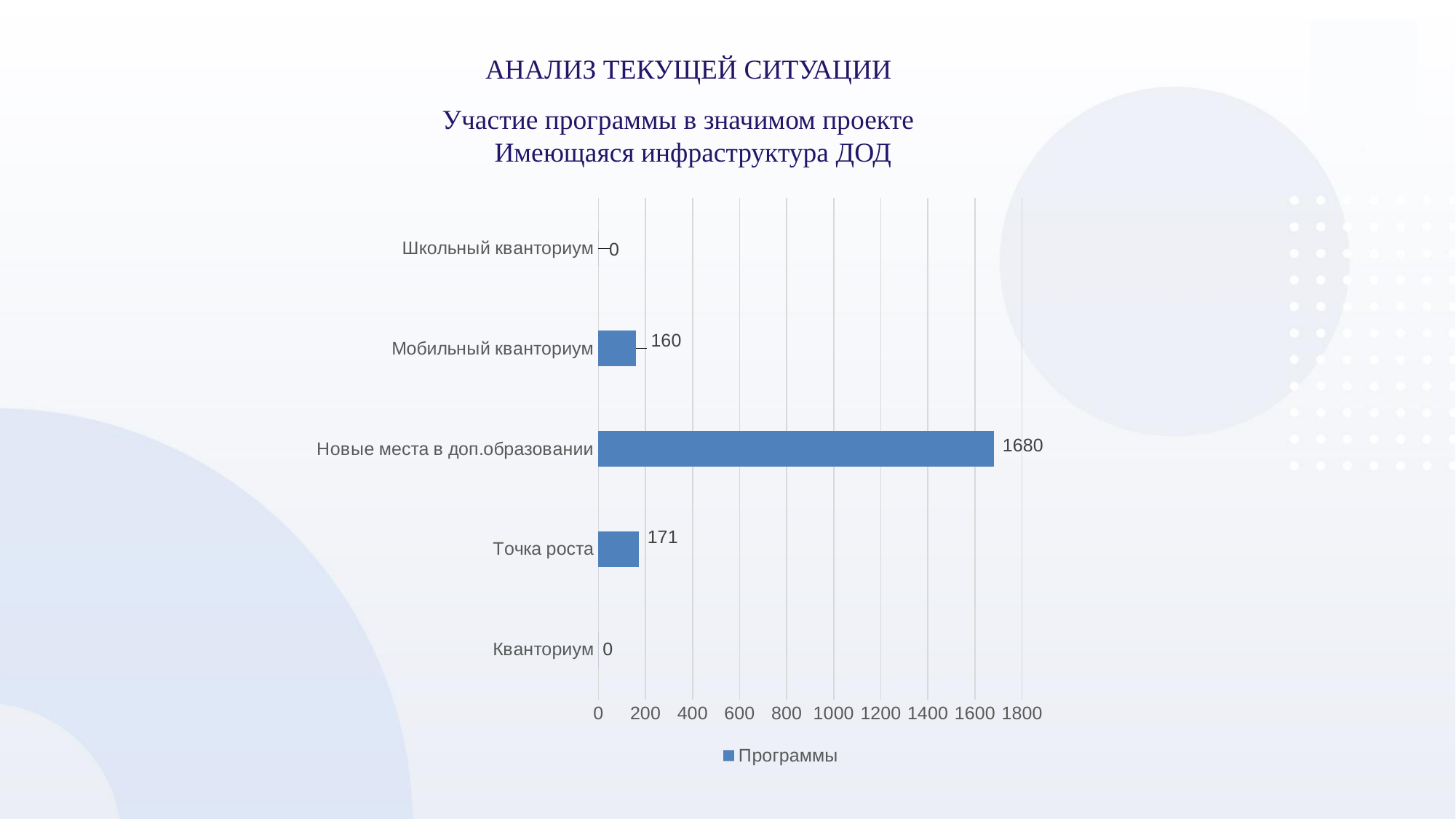
What is the value for Точка роста? 171 What is the difference between the values for Точка роста and Мобильный кванториум? 11 How many series does the legend list? 1 Which is larger, the value for Точка роста or the value for Мобильный кванториум? Точка роста What is the value for Мобильный кванториум? 160 How many categories are shown on the chart? 5 What is the value for Новые места в доп.образовании? 1680 Which category has the highest value? Новые места в доп.образовании What is the difference between the values for Новые места в доп.образовании and Точка роста? 1509 Is the value for Новые места в доп.образовании greater or less than 1600? greater What is the value for Школьный кванториум? 0 What kind of chart is shown on the slide? bar chart